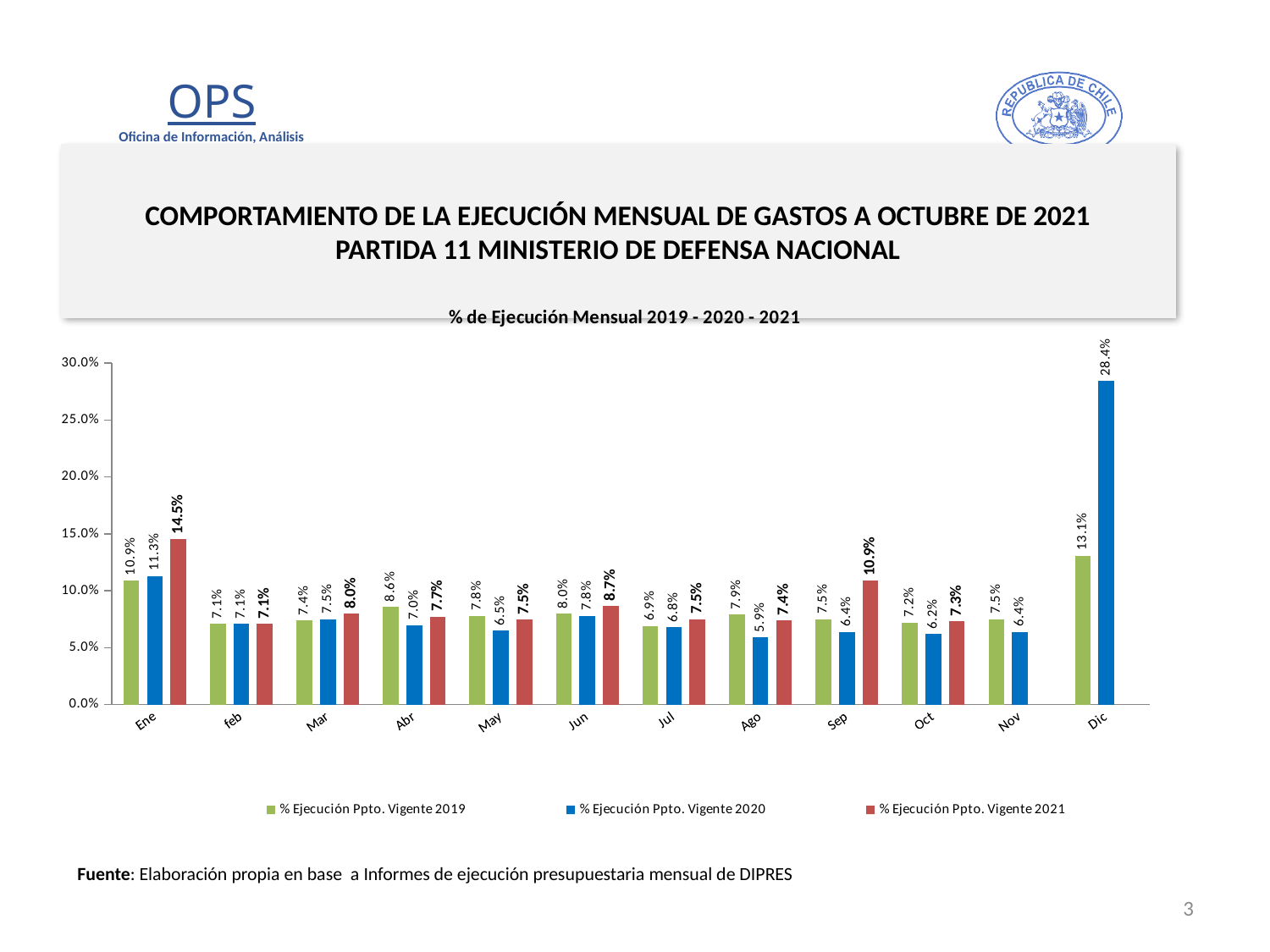
How many months are shown on the x axis? 12 How many series does the legend list? 3 Is the % Ejecución Ppto. Vigente 2020 value for Dic greater or less than 25.0%? greater What is the difference between the 2020 and 2019 values for Dic? 15.3% What is the % Ejecución Ppto. Vigente 2020 value for Dic? 28.4% Which month has the highest % Ejecución Ppto. Vigente 2020 value? Dic Which is larger for Ago: the % Ejecución Ppto. Vigente 2019 value or the 2020 value? % Ejecución Ppto. Vigente 2019 Which month has the lowest % Ejecución Ppto. Vigente 2020 value? Ago What is the % Ejecución Ppto. Vigente 2021 value for Sep? 10.9% What is the % Ejecución Ppto. Vigente 2021 value for Ene? 14.5% What kind of chart is shown? Bar chart What is the % Ejecución Ppto. Vigente 2019 value for Abr? 8.6%